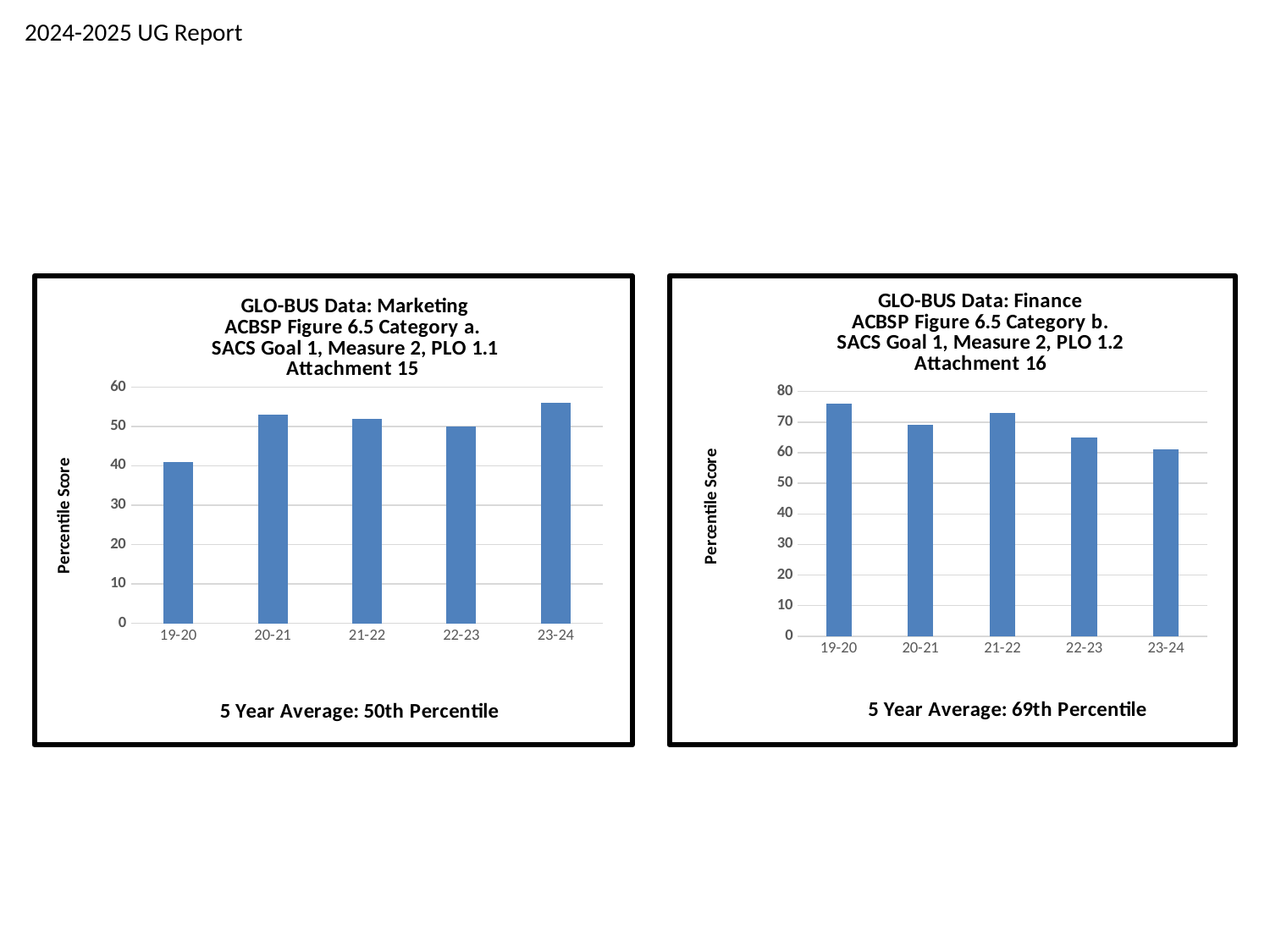
What 5 year average is stated below the GLO-BUS Data: Finance chart? 69th Percentile In the GLO-BUS Data: Finance chart, is the value for 22-23 greater or less than 70? less In the GLO-BUS Data: Marketing chart, how many years are plotted? 5 What 5 year average is stated below the GLO-BUS Data: Marketing chart? 50th Percentile What kind of chart is the GLO-BUS Data: Finance chart? bar chart In the GLO-BUS Data: Finance chart, is the value for 19-20 larger or smaller than the value for 23-24? larger In the GLO-BUS Data: Marketing chart, is the value for 19-20 greater or less than 50? less In the GLO-BUS Data: Marketing chart, which year has the lowest percentile score? 19-20 In the GLO-BUS Data: Finance chart, which year has the lowest percentile score? 23-24 In the GLO-BUS Data: Finance chart, which year has the highest percentile score? 19-20 In the GLO-BUS Data: Marketing chart, which year has the highest percentile score? 23-24 In the GLO-BUS Data: Finance chart, is the value for 19-20 greater or less than 70? greater